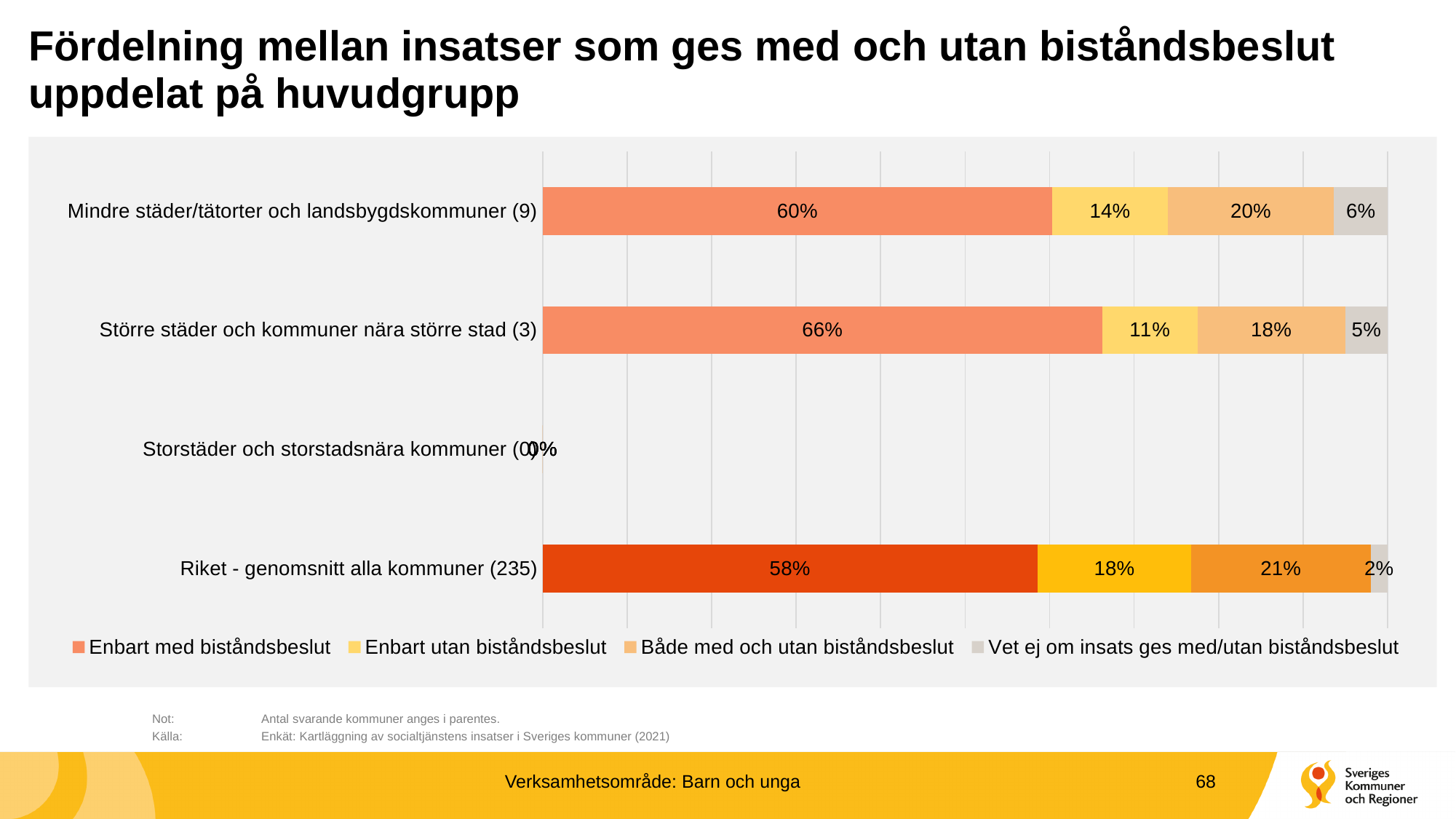
How many series does the legend list? 4 What is the value for 'Enbart med biståndsbeslut' for 'Mindre städer/tätorter och landsbygdskommuner (9)'? 60% Which has the larger value for 'Enbart utan biståndsbeslut': 'Riket - genomsnitt alla kommuner (235)' or 'Mindre städer/tätorter och landsbygdskommuner (9)'? Riket - genomsnitt alla kommuner (235) What kind of chart is shown on the slide? Stacked bar chart What is the difference in 'Enbart med biståndsbeslut' between 'Större städer och kommuner nära större stad (3)' and 'Mindre städer/tätorter och landsbygdskommuner (9)'? 6 percentage points How many categories are shown on the vertical axis of the chart? 4 What is the value for 'Både med och utan biståndsbeslut' for 'Riket - genomsnitt alla kommuner (235)'? 21% Which category has the highest value for 'Enbart med biståndsbeslut'? Större städer och kommuner nära större stad (3) What is the value for 'Enbart utan biståndsbeslut' for 'Större städer och kommuner nära större stad (3)'? 11% Which series is shown in grey in the legend? Vet ej om insats ges med/utan biståndsbeslut What is the total of the stacked bar for 'Mindre städer/tätorter och landsbygdskommuner (9)'? 100% What is the value for 'Vet ej om insats ges med/utan biståndsbeslut' for 'Större städer och kommuner nära större stad (3)'? 5%